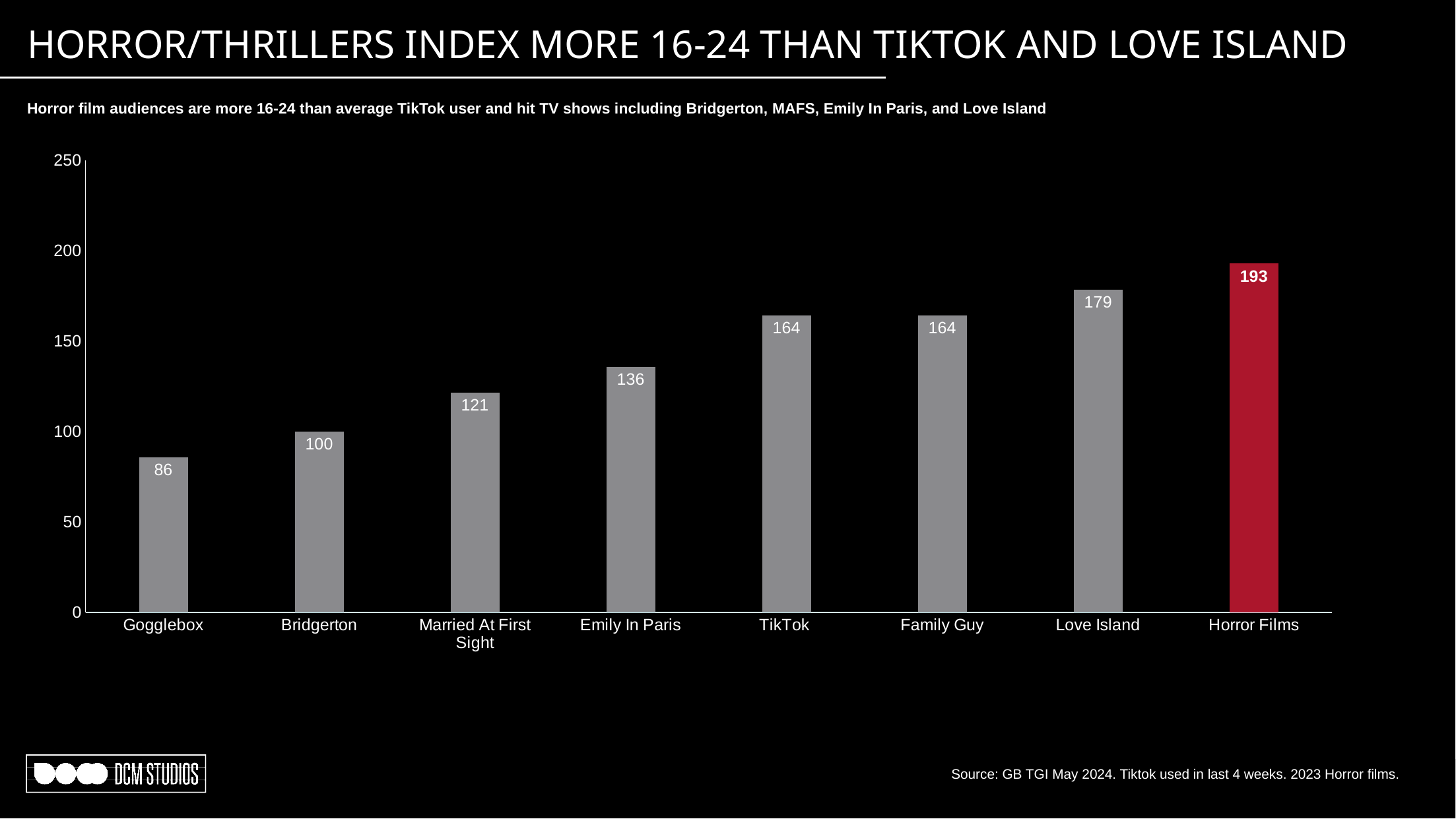
Which category has the highest value? Horror Films What kind of chart is shown on the slide? Bar chart What is the value for Gogglebox? 86 Which is larger, the value for Married At First Sight or the value for Emily In Paris? Emily In Paris What is the value for Emily In Paris? 136 Which bar is coloured red rather than grey? Horror Films What is the value for Horror Films? 193 What is the difference between the values for Horror Films and TikTok? 29 What is the difference between the values for Love Island and Bridgerton? 79 What is the value for Love Island? 179 How many categories are shown on the x axis? 8 Which category has the lowest value? Gogglebox